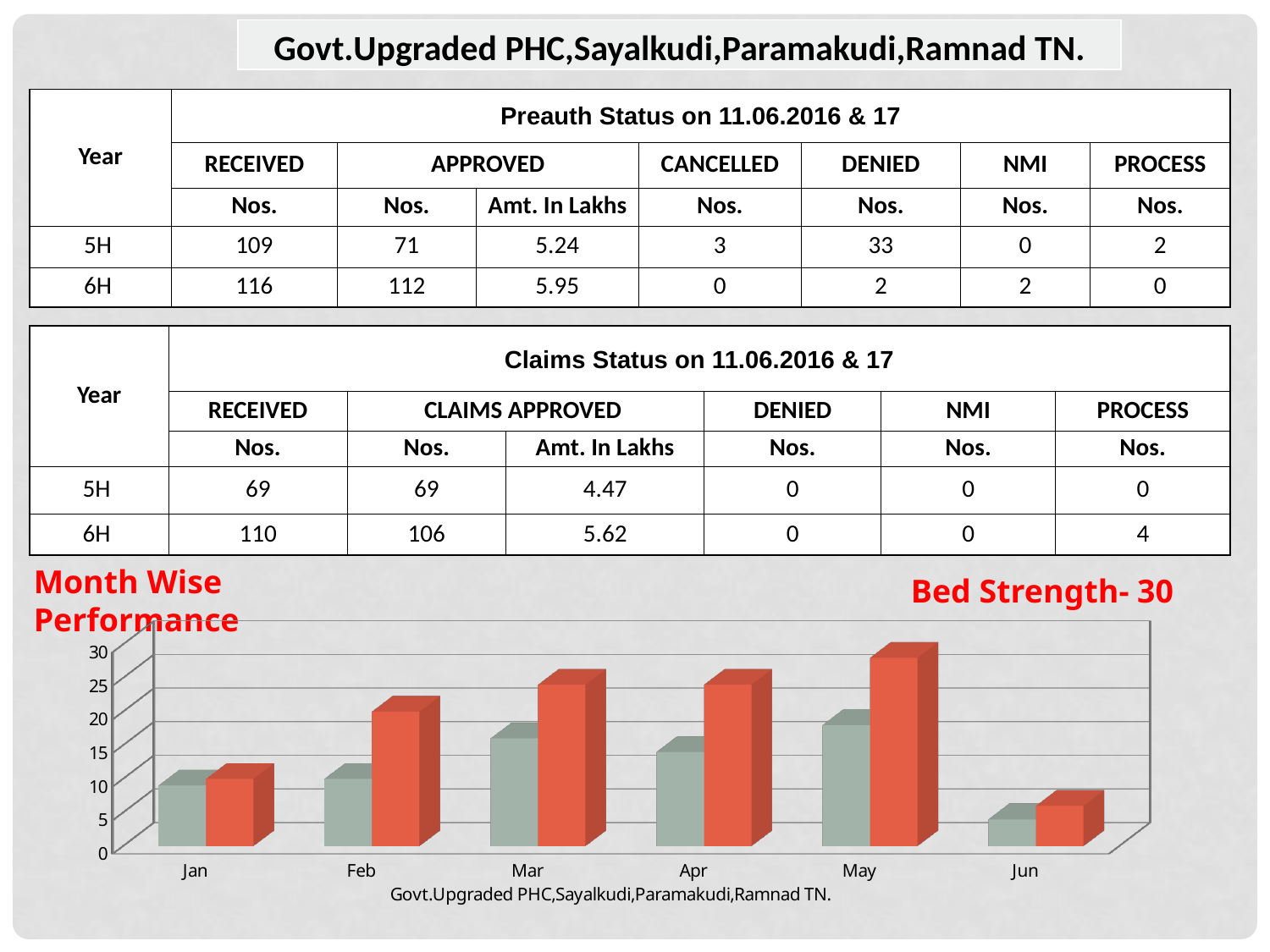
Which is larger, the red bar for Jan or the red bar for Feb? Feb In which month is the red bar the tallest? May How many bars are plotted for each month in the bar chart? 2 How many months are shown on the x axis of the bar chart? 6 Is the grey bar for Jan greater or less than 15? less What kind of chart is shown at the bottom of the slide? bar chart What title is printed below the bar chart? Govt.Upgraded PHC,Sayalkudi,Paramakudi,Ramnad TN. Is the red bar for Feb greater or less than 15? greater In which month is the grey bar the shortest? Jun Is the red bar for Jun greater or less than 10? less In which month is the red bar the shortest? Jun